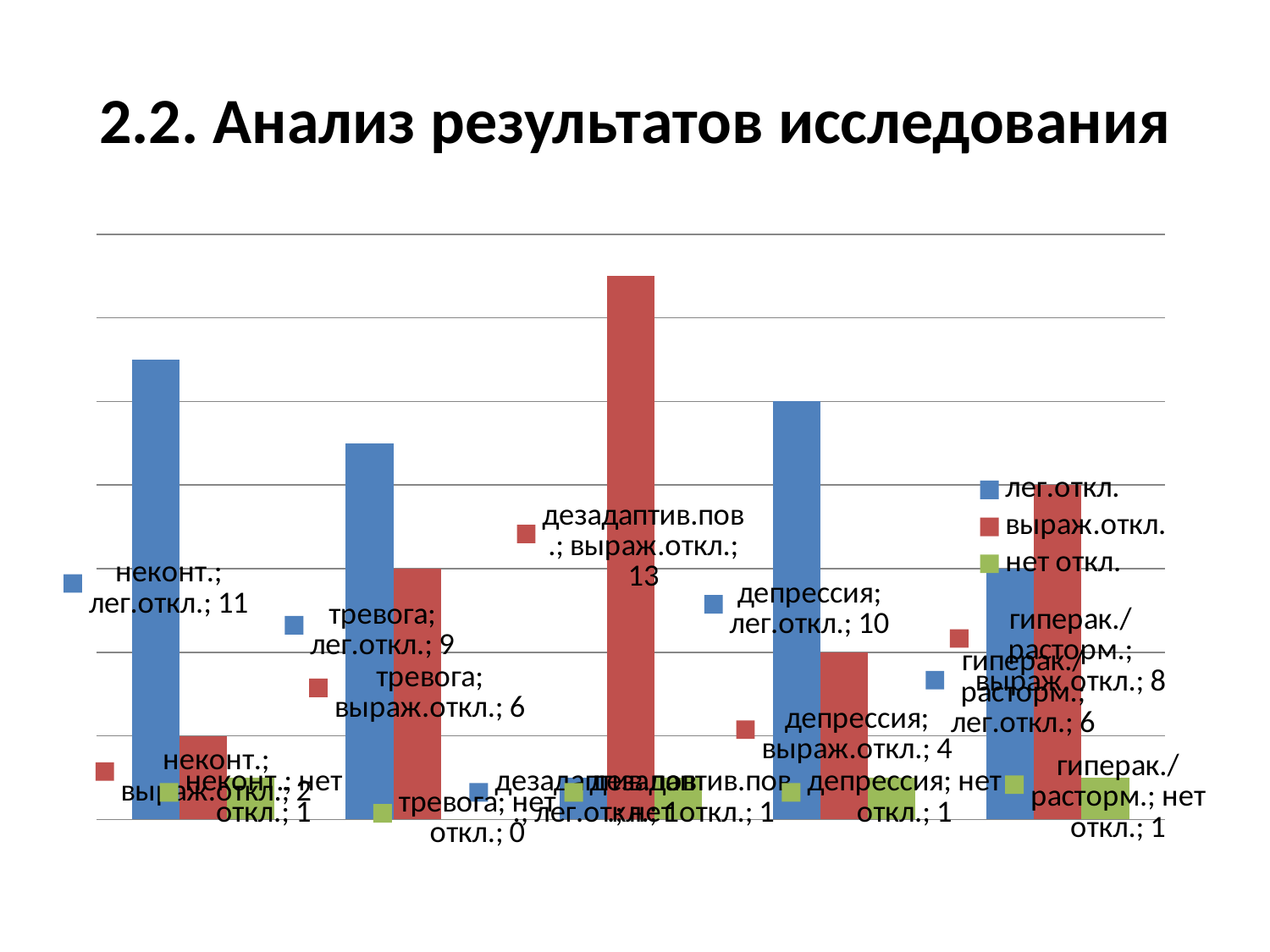
What is the difference between лег.откл. and выраж.откл. for тревога? 3 What is the value of выраж.откл. for гиперак./расторм.? 8 What kind of chart is shown on the slide? bar chart What is the value of нет откл. for тревога? 0 Which category has the highest выраж.откл. value? дезадаптив.пов. What is the value of выраж.откл. for дезадаптив.пов.? 13 How many series does the legend list? 3 What is the value of лег.откл. for неконт.? 11 Which category has the highest лег.откл. value? неконт. Which series is shown in green in the legend? нет откл. Which is larger for депрессия: лег.откл. or выраж.откл.? лег.откл. What is the value of лег.откл. for депрессия? 10